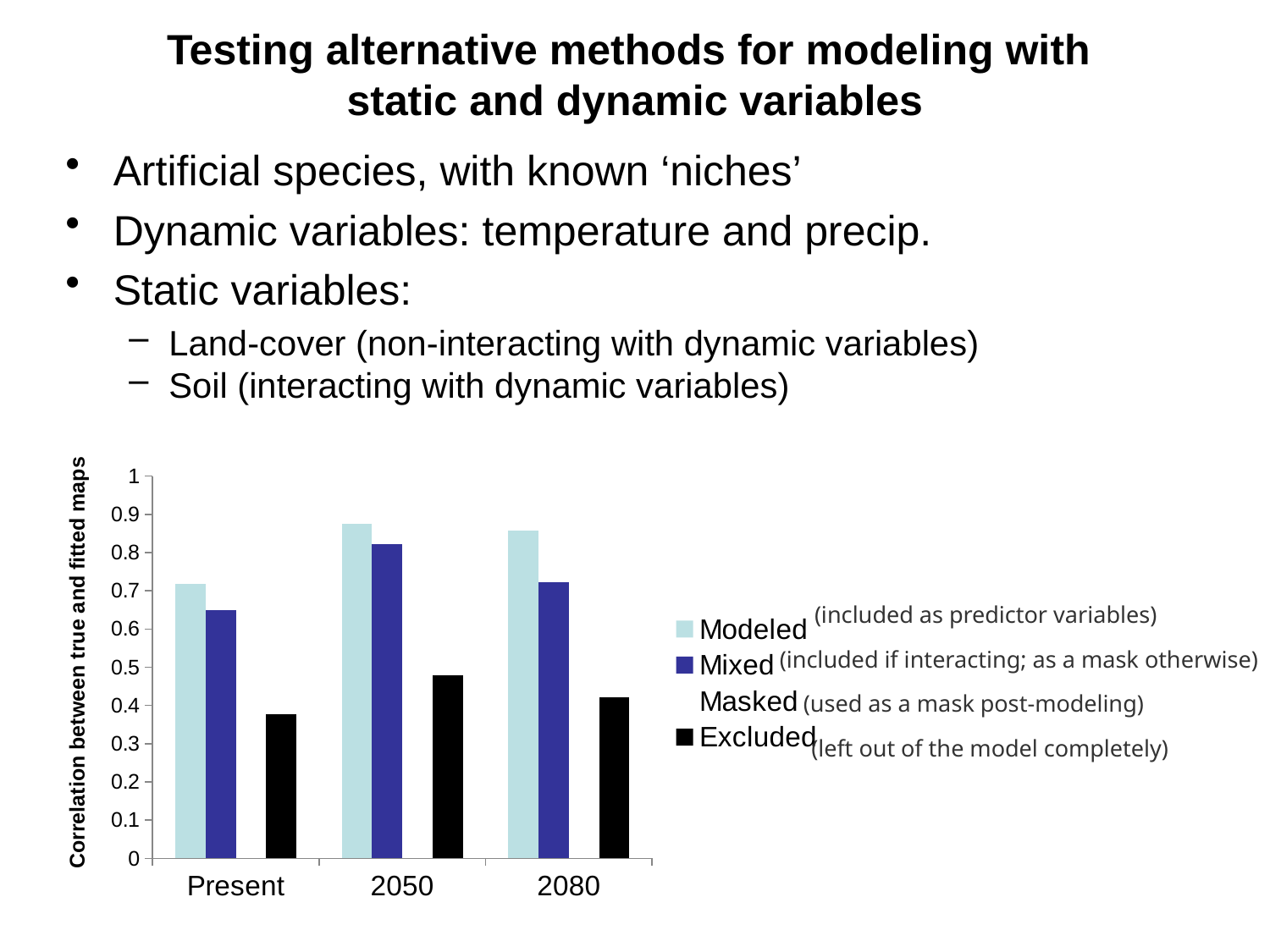
Which series has the highest bar in the 2050 category? Modeled How many series does the chart legend list? 4 How many categories are shown on the x axis of the chart? 3 Which series has the lowest bar in the Present category? Excluded What is the title of the chart's vertical axis? Correlation between true and fitted maps In which category is the Mixed bar the lowest? Present Is the Excluded value for 2080 greater or less than 0.6? less What colour are the Excluded bars in the chart? black Is the Modeled value for Present greater or less than 0.6? greater In which category is the Excluded bar the highest? 2050 What kind of chart is shown on the slide? bar chart Which is larger, the Mixed value for 2080 or the Mixed value for Present? 2080